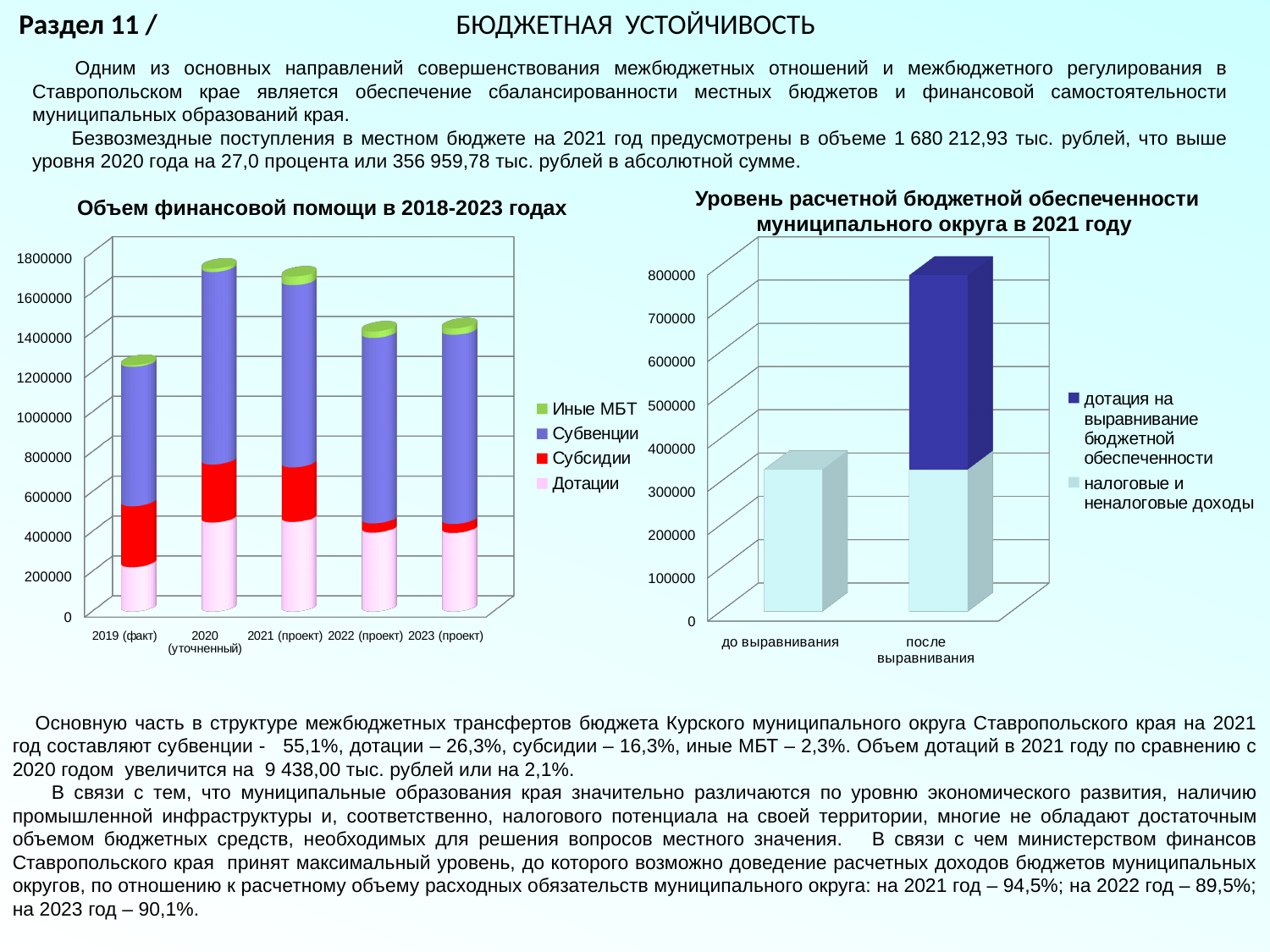
In the chart 'Объем финансовой помощи в 2018-2023 годах', is the total bar for 2020 (уточненный) greater or less than 1600000? greater How many series does the legend of the chart 'Объем финансовой помощи в 2018-2023 годах' list? 4 In the chart 'Уровень расчетной бюджетной обеспеченности муниципального округа в 2021 году', which bar is taller: 'до выравнивания' or 'после выравнивания'? после выравнивания How many series does the legend of the chart 'Уровень расчетной бюджетной обеспеченности муниципального округа в 2021 году' list? 2 What kind of chart is 'Объем финансовой помощи в 2018-2023 годах'? stacked bar chart In the chart 'Объем финансовой помощи в 2018-2023 годах', which series is shown in red? Субсидии In the chart 'Объем финансовой помощи в 2018-2023 годах', which category has the lowest total bar? 2019 (факт) In the chart 'Объем финансовой помощи в 2018-2023 годах', is the total bar for 2019 (факт) greater or less than 1400000? less In the chart 'Уровень расчетной бюджетной обеспеченности муниципального округа в 2021 году', is the value for 'до выравнивания' greater or less than 400000? less How many categories are shown on the x axis of the chart 'Объем финансовой помощи в 2018-2023 годах'? 5 What kind of chart is 'Уровень расчетной бюджетной обеспеченности муниципального округа в 2021 году'? stacked bar chart